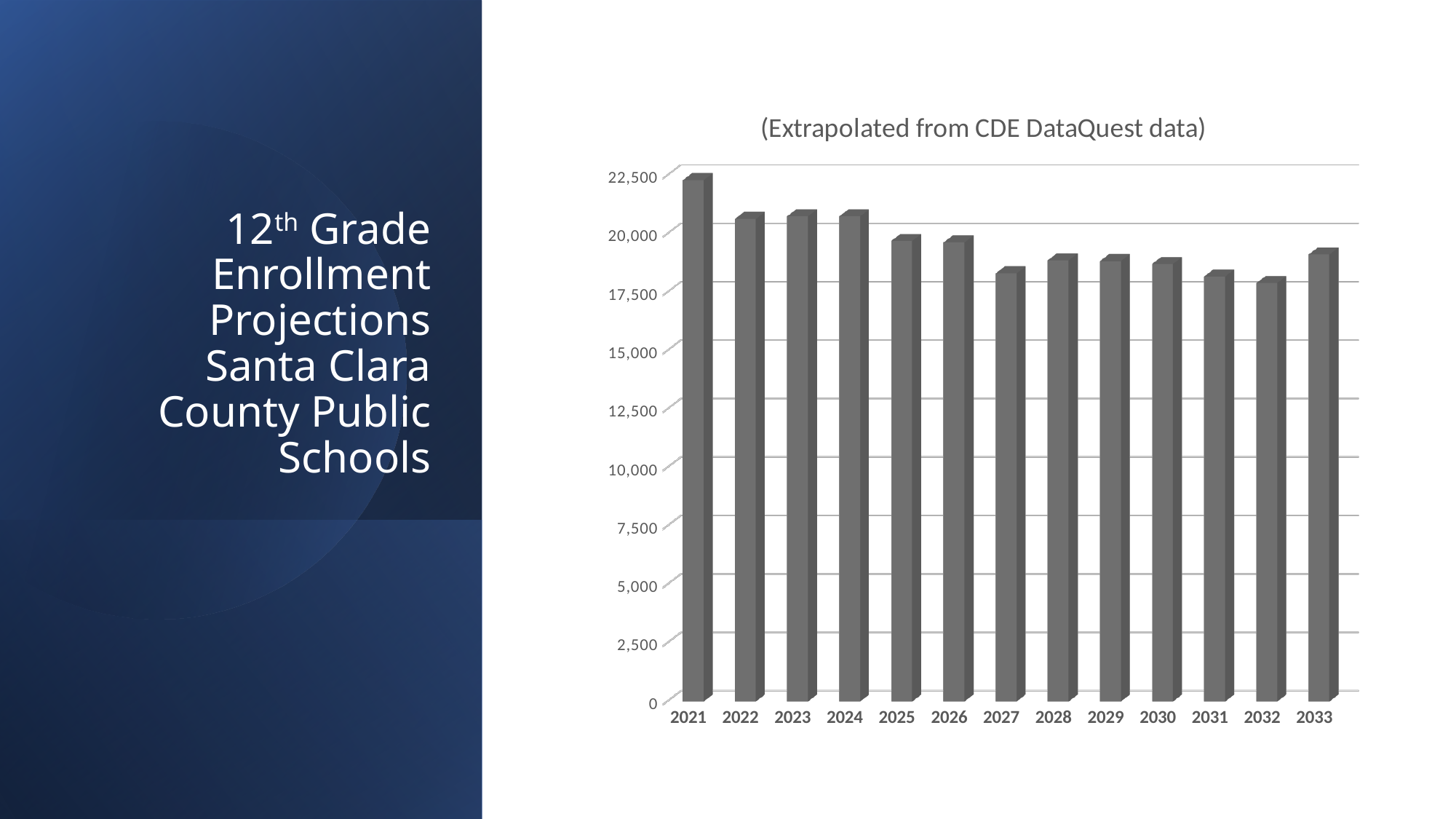
Which year has the lowest projected 12th grade enrollment? 2032 Which year has the highest projected 12th grade enrollment? 2021 How many years are plotted on the x axis of the chart? 13 What kind of chart is shown on the slide? Bar chart Is the value for 2021 greater or less than 20,000? greater Which is larger, the value for 2021 or the value for 2033? 2021 What is the title shown above the chart? (Extrapolated from CDE DataQuest data) Is the value for 2022 greater or less than 20,000? greater Which is larger, the value for 2025 or the value for 2027? 2025 Do the values generally rise or fall from 2021 to 2032? Fall Is the value for 2027 greater or less than 17,500? greater